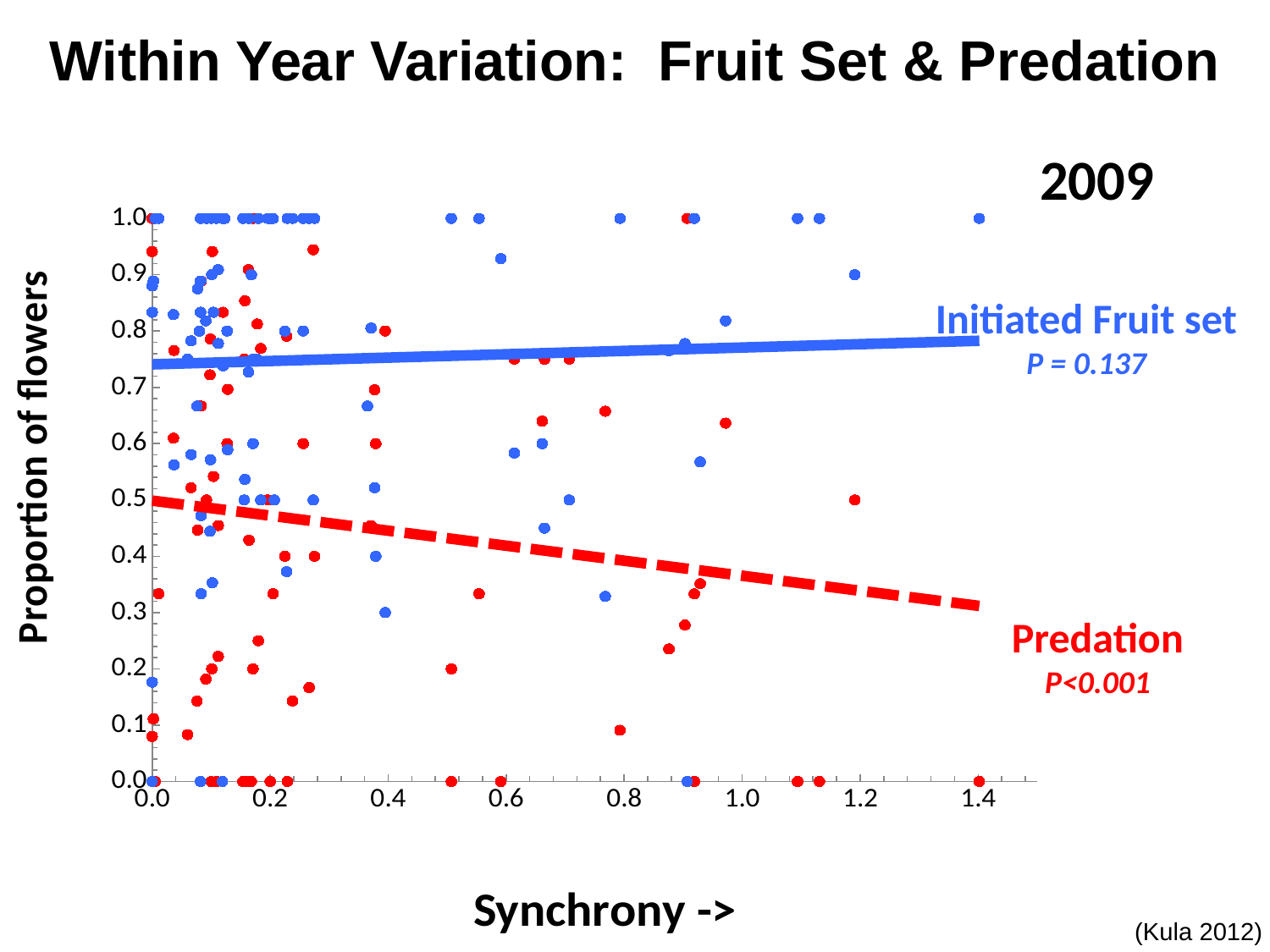
Does the Initiated Fruit set trend line rise or fall as Synchrony increases? Rise Does the Predation trend line rise or fall as Synchrony increases? Fall What P value is shown for the Predation series? P<0.001 Is the Predation trend line at Synchrony 1.4 greater or less than 0.4? less What P value is shown for the Initiated Fruit set series? P = 0.137 Is the Predation trend line at Synchrony 0.0 greater or less than 0.4? greater How many data series are plotted on the chart? 2 What kind of chart is shown on the slide? Scatter plot Which series is plotted in red? Predation Is the Initiated Fruit set trend line at Synchrony 0.0 greater or less than 0.7? greater Which trend line is higher across the chart, Initiated Fruit set or Predation? Initiated Fruit set Which series is plotted in blue? Initiated Fruit set